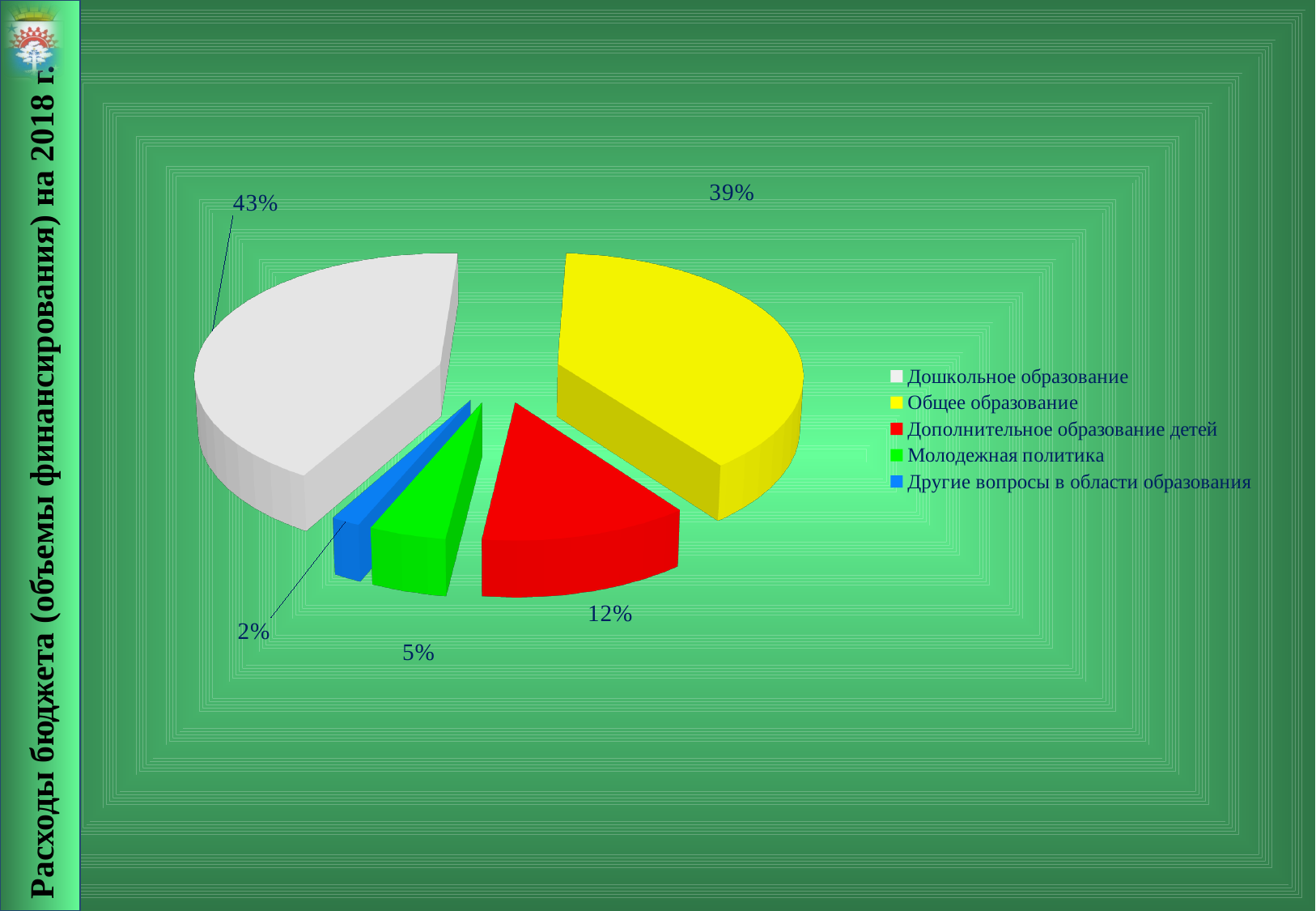
Which is larger, the share for Дополнительное образование детей or the share for Молодежная политика? Дополнительное образование детей What share of the pie does Дополнительное образование детей have? 12% Which category has the largest share of the pie? Дошкольное образование Which colour represents Общее образование in the legend? Yellow What share of the pie does Дошкольное образование have? 43% What kind of chart is shown on the slide? Pie chart What is the difference in percentage points between Дошкольное образование and Общее образование? 4 How many slices does the pie chart have? 5 What share of the pie does Молодежная политика have? 5% Which category has the smallest share of the pie? Другие вопросы в области образования What share of the pie does Общее образование have? 39% What share of the pie does Другие вопросы в области образования have? 2%